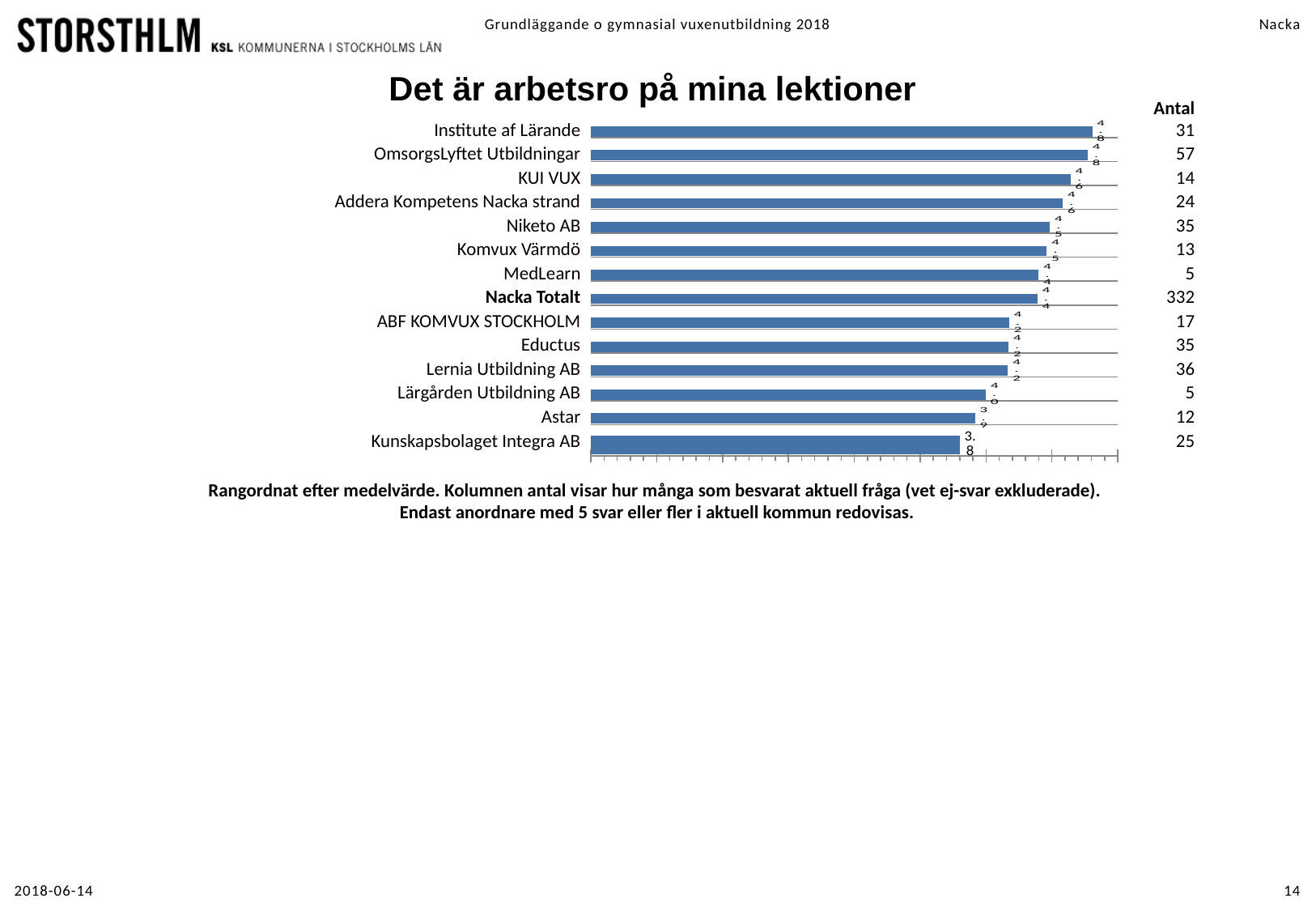
How many categories (anordnare, including Nacka Totalt) are plotted in the chart? 14 Which has a larger value, KUI VUX or Astar? KUI VUX What is the value shown for Kunskapsbolaget Integra AB? 3.8 What is the title of the chart? Det är arbetsro på mina lektioner What is the value shown for Nacka Totalt? 4.4 What is the value shown for Institute af Lärande? 4.8 What kind of chart is shown on the slide? bar chart According to the Antal column, how many respondents answered for Nacka Totalt? 332 What is the value shown for Lärgården Utbildning AB? 4.0 Which category has the lowest value in the chart? Kunskapsbolaget Integra AB Do the values rise or fall going from the top category to the bottom category? fall What is the difference between the value for Institute af Lärande and the value for Kunskapsbolaget Integra AB? 1.0